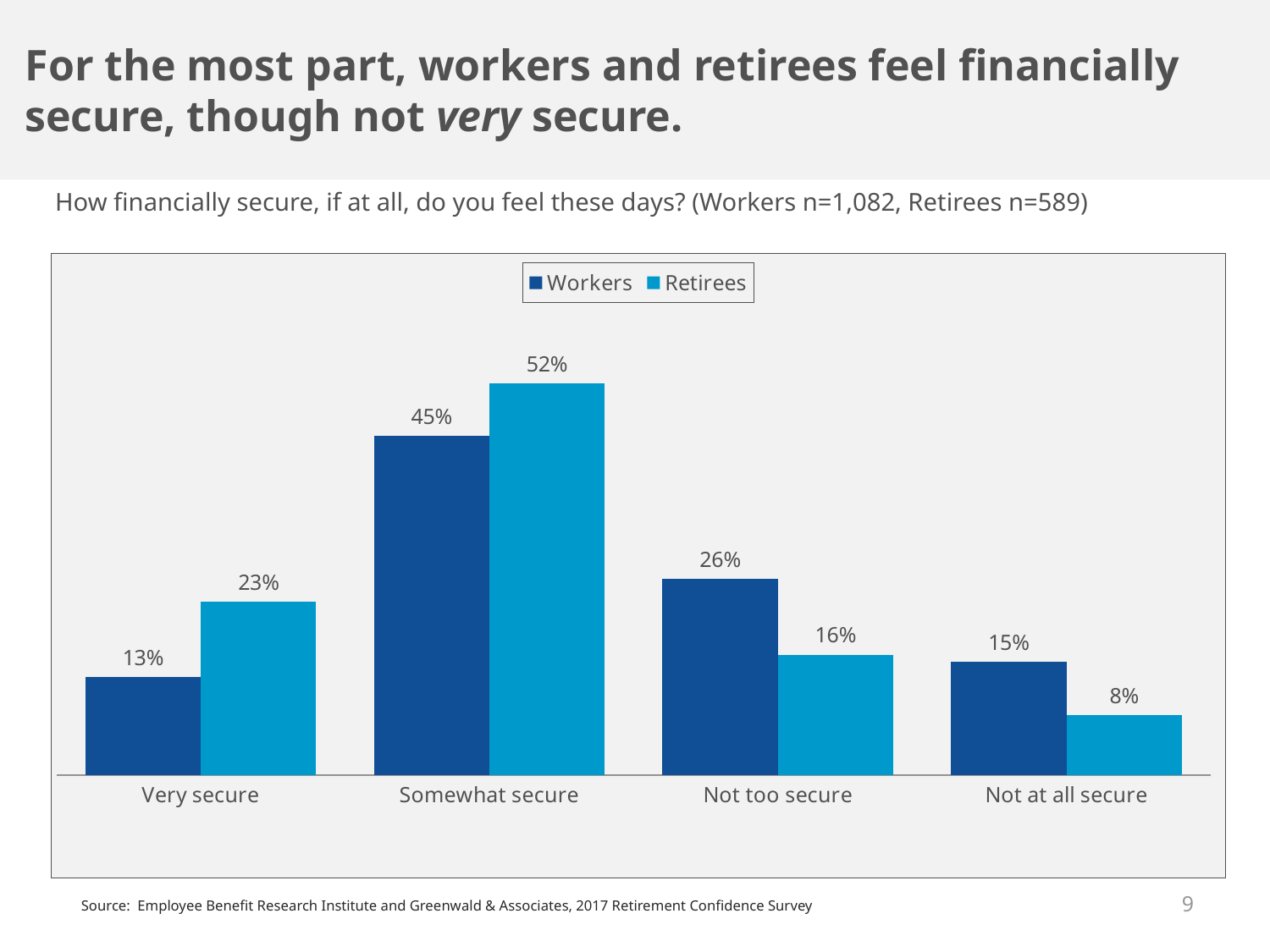
Which is larger for Not at all secure, Workers or Retirees? Workers What percentage of Retirees feel Very secure? 23% Which category has the lowest value for Workers? Very secure What is the difference between Retirees and Workers for Somewhat secure? 7% How many series does the legend list? 2 What percentage of Retirees feel Not at all secure? 8% What is the difference between Workers and Retirees for Not too secure? 10% How many response categories are shown on the x axis? 4 Which category has the highest value for Retirees? Somewhat secure What percentage of Workers feel Somewhat secure? 45% What kind of chart is shown on the slide? Bar chart What are the two series named in the legend? Workers and Retirees